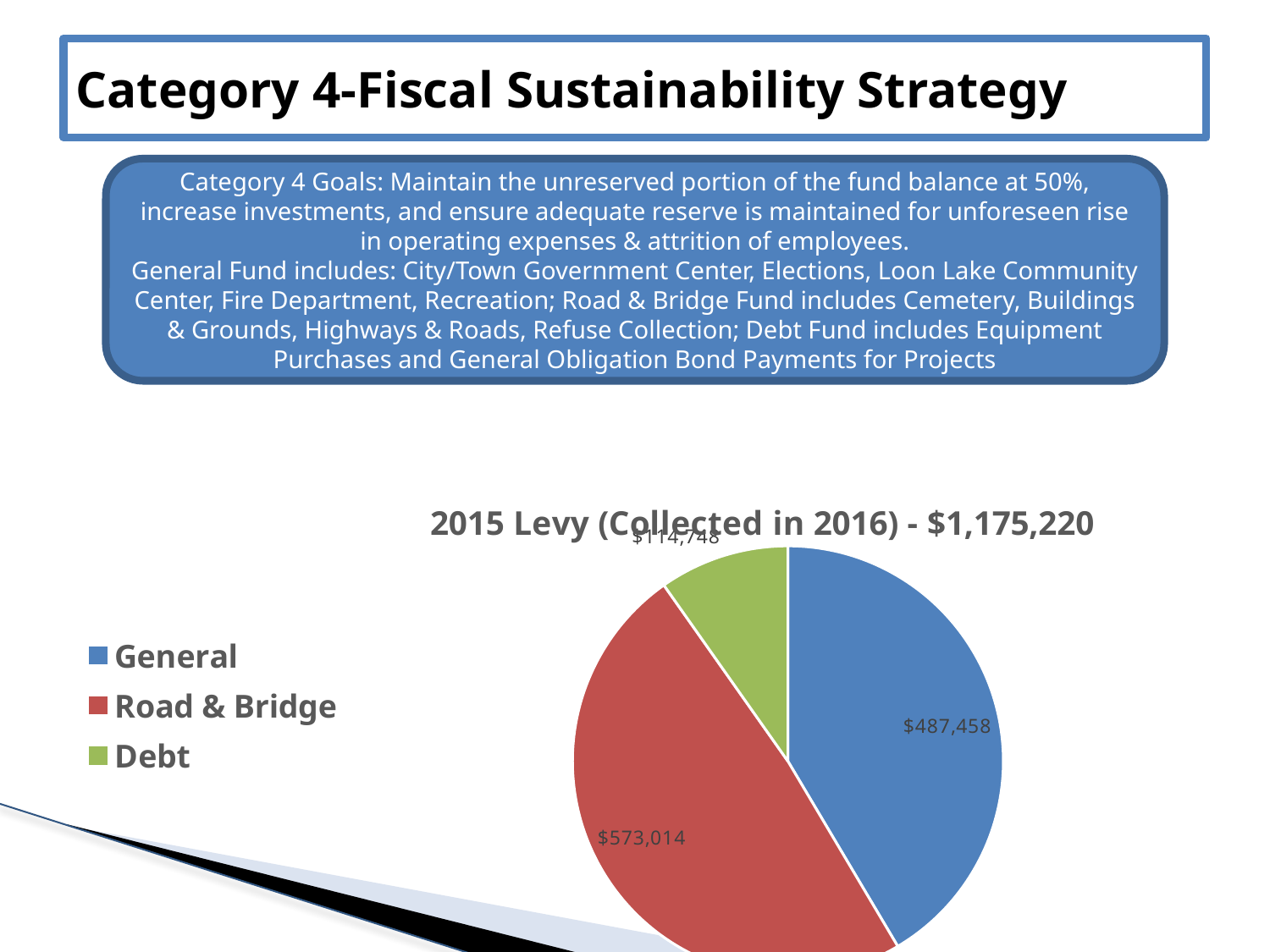
What type of chart is shown on the slide? Pie chart Which category has the smallest slice in the pie chart? Debt Which colour represents Debt in the pie chart? Green What is the title of the pie chart? 2015 Levy (Collected in 2016) - $1,175,220 How many entries does the legend of the pie chart list? 3 What is the difference between the Road & Bridge value and the General value in the pie chart? $85,556 What is the value of the Road & Bridge slice in the pie chart? $573,014 Which is larger in the pie chart, General or Road & Bridge? Road & Bridge What is the value of the Debt slice in the pie chart? $114,748 What is the value of the General slice in the pie chart? $487,458 Which category has the largest slice in the pie chart? Road & Bridge How many slices does the pie chart have? 3